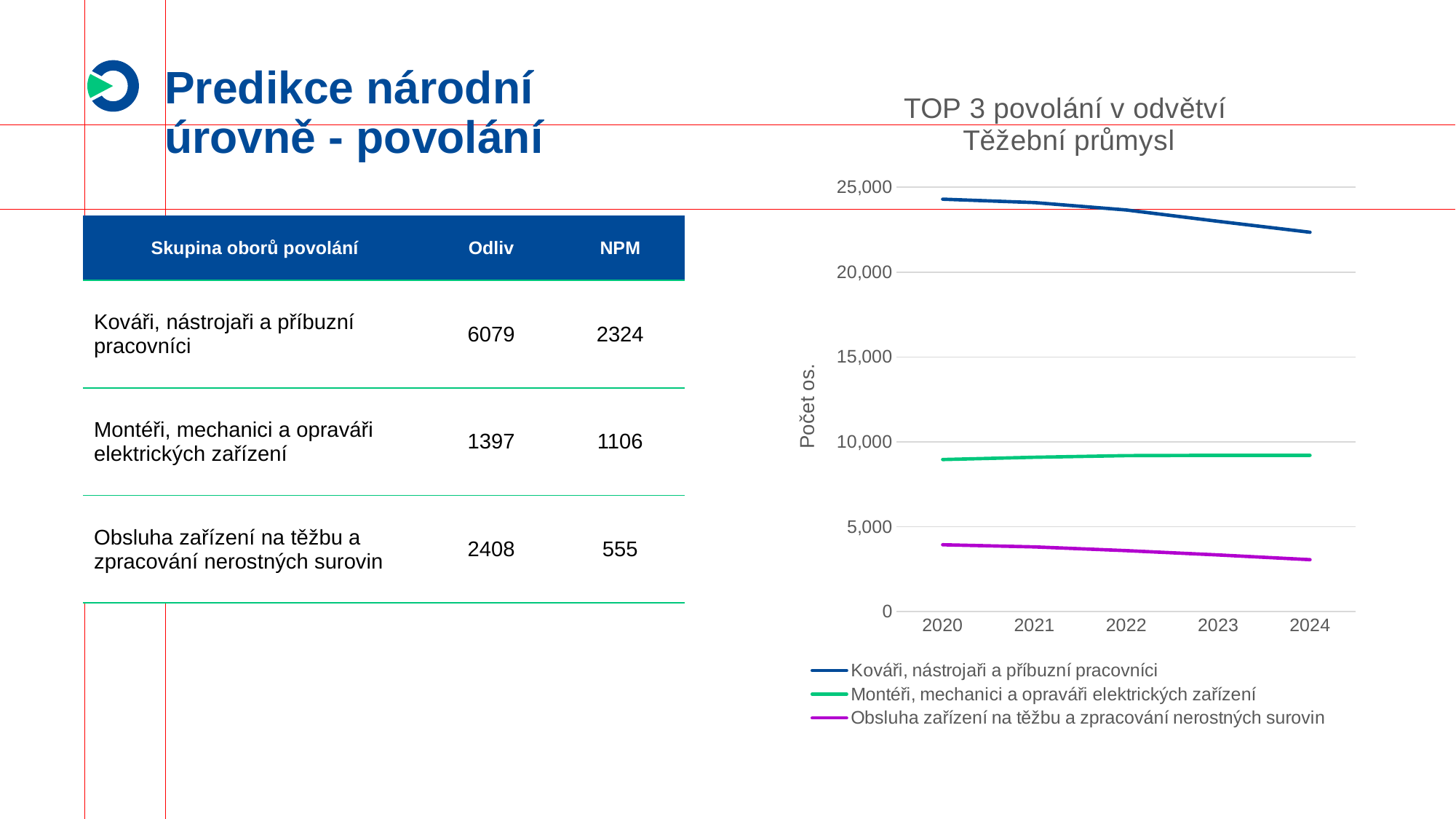
Which is larger in 2022: the value for Montéři, mechanici a opraváři elektrických zařízení or the value for Obsluha zařízení na těžbu a zpracování nerostných surovin? Montéři, mechanici a opraváři elektrických zařízení How many series does the chart legend list? 3 What is the label of the y axis of the chart? Počet os. Is the value for Kováři, nástrojaři a příbuzní pracovníci in 2024 greater or less than 20,000? greater Which series has the highest values in the chart? Kováři, nástrojaři a příbuzní pracovníci Is the value for Obsluha zařízení na těžbu a zpracování nerostných surovin in 2024 greater or less than 5,000? less Does the line for Kováři, nástrojaři a příbuzní pracovníci rise or fall from 2020 to 2024? fall Does the line for Obsluha zařízení na těžbu a zpracování nerostných surovin rise or fall from 2020 to 2024? fall How many years are shown on the x axis of the chart? 5 Which series has the lowest values in the chart? Obsluha zařízení na těžbu a zpracování nerostných surovin Is the value for Montéři, mechanici a opraváři elektrických zařízení in 2020 greater or less than 10,000? less What kind of chart is shown on the slide? line chart